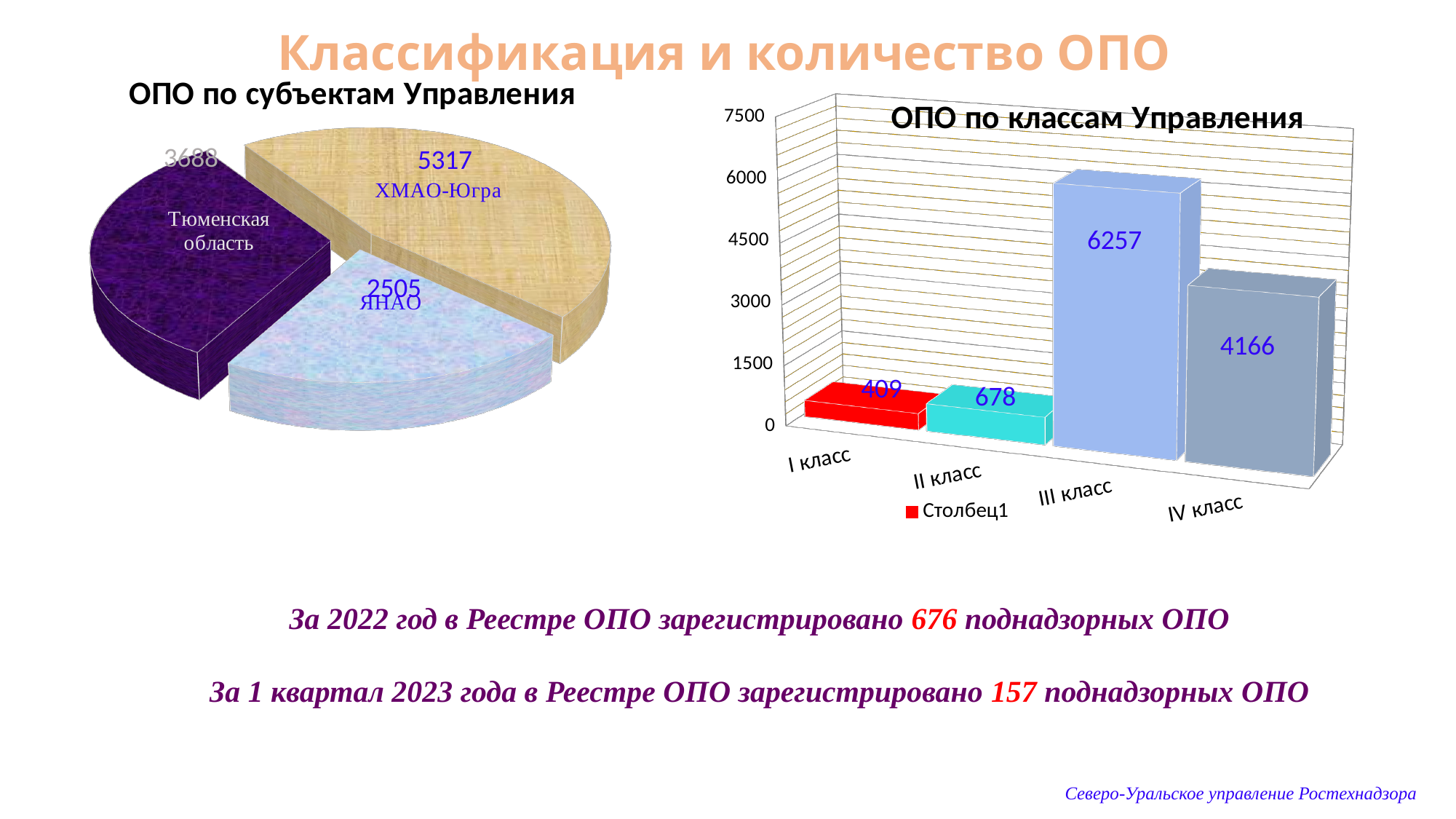
What kind of chart is 'ОПО по субъектам Управления'? Pie chart In the chart 'ОПО по классам Управления', which class has the highest value? III класс In the chart 'ОПО по субъектам Управления', how many slices does the pie have? 3 What kind of chart is 'ОПО по классам Управления'? Bar chart In the chart 'ОПО по субъектам Управления', what is the value for ХМАО-Югра? 5317 In the chart 'ОПО по классам Управления', what is the value for I класс? 409 In the chart 'ОПО по субъектам Управления', what is the difference between ХМАО-Югра and ЯНАО? 2812 In the chart 'ОПО по классам Управления', which is larger: II класс or I класс? II класс In the chart 'ОПО по классам Управления', what is the value for III класс? 6257 In the chart 'ОПО по субъектам Управления', what is the value for Тюменская область? 3688 In the chart 'ОПО по классам Управления', what is the difference between III класс and IV класс? 2091 In the chart 'ОПО по субъектам Управления', which region has the smallest slice? ЯНАО